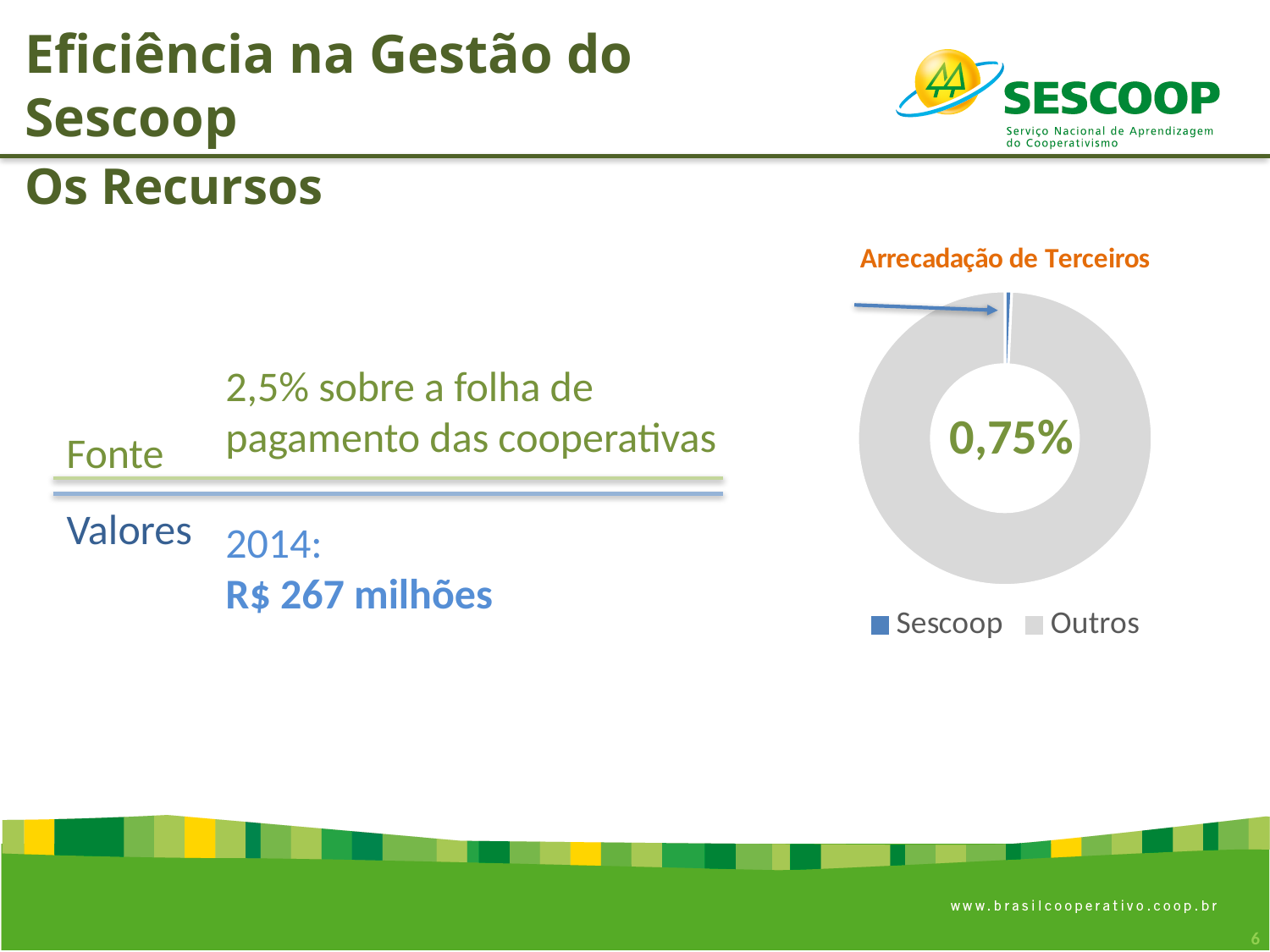
Is the share of Outros in the chart greater or less than 50%? greater What colour represents Sescoop in the chart? blue Which category has the largest slice in the chart? Outros Which slice is larger, Sescoop or Outros? Outros How many categories does the chart's legend list? 2 Is the share of Sescoop in the chart greater or less than 50%? less What percentage value is printed in the centre of the chart? 0,75% Which category has the smallest slice in the chart? Sescoop What kind of chart is shown on the slide? doughnut chart What is the title of the chart on the slide? Arrecadação de Terceiros